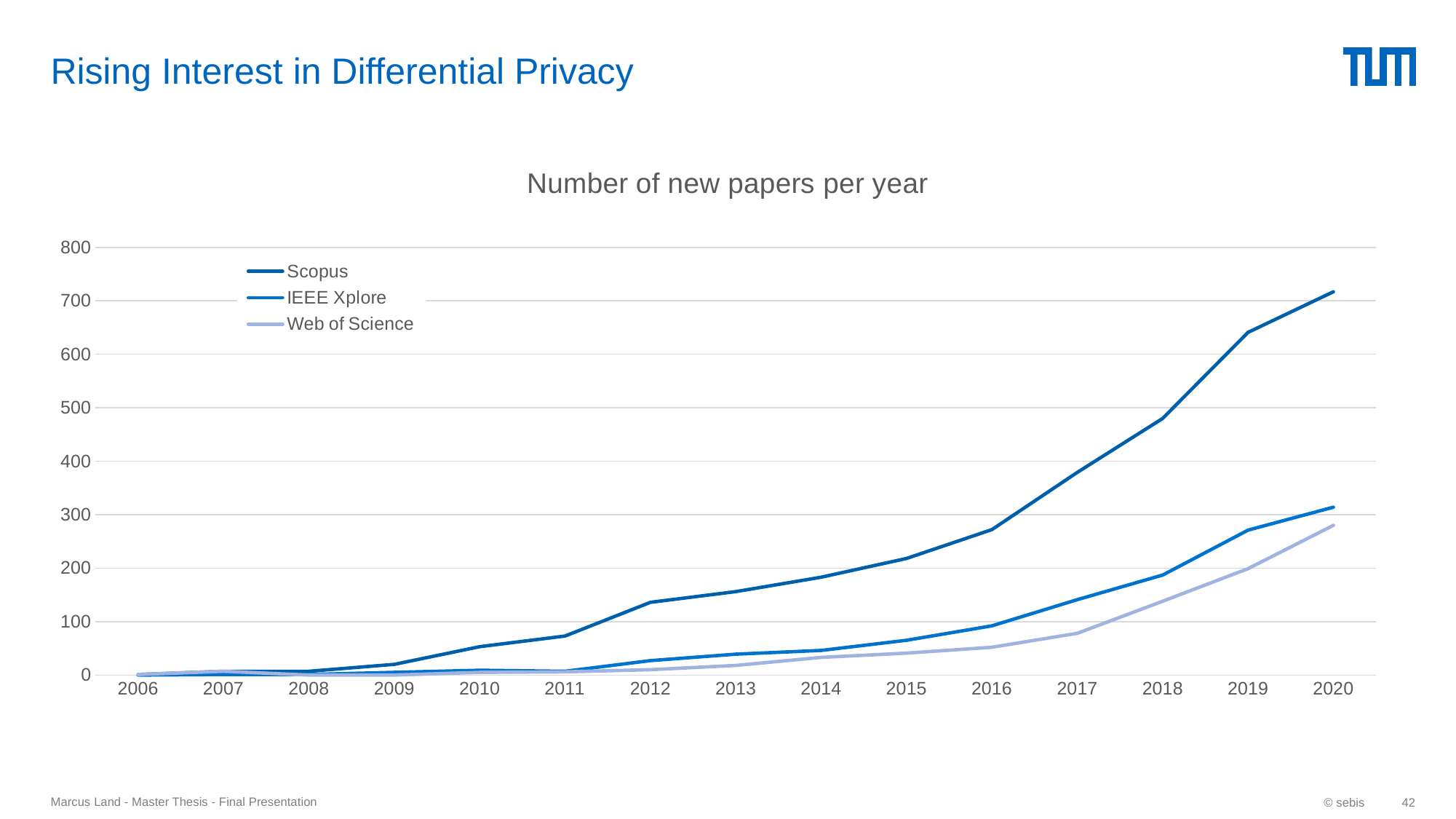
How many years are shown on the x axis? 15 What is the title of the chart? Number of new papers per year Is the IEEE Xplore value for 2020 greater or less than 300? greater Which series has the lowest value in 2020? Web of Science Is the Scopus value for 2018 greater or less than 500? less Which series has the highest value in 2020? Scopus What kind of chart is shown on the slide? line chart Is the Web of Science value for 2017 greater or less than 100? less How many series does the legend list? 3 Which is larger in 2016, the Scopus value or the IEEE Xplore value? Scopus Do the Scopus values rise or fall from 2012 to 2020? rise